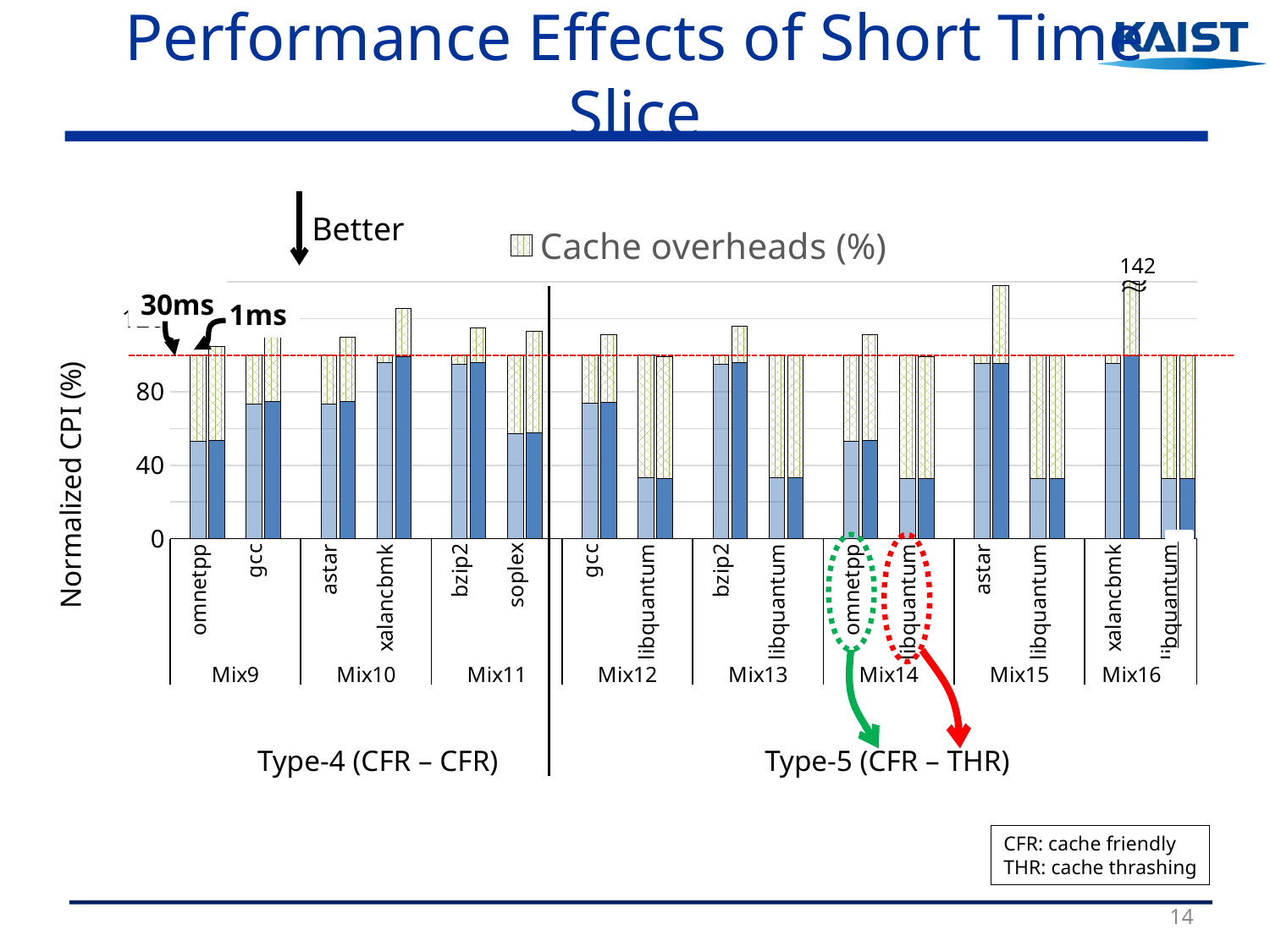
Is the solid (non-hatched) portion of the bars for omnetpp in Mix9 greater or less than 80? less In Mix9, which benchmark has the larger solid (non-hatched) bar portion, omnetpp or gcc? gcc What kind of chart is shown on the slide? bar chart In Mix16, which benchmark has the taller total bar, xalancbmk or libquantum? xalancbmk How many benchmark categories are shown in the Mix10 group? 2 How many Mix groups are shown along the x-axis? 8 Is the total height of the bars for libquantum in Mix12 greater or less than 80? greater What entry does the chart legend list? Cache overheads (%) Is the solid (non-hatched) portion of the bars for libquantum in Mix12 greater or less than 40? less What value is printed above the tallest bar in the chart? 142 What is the label of the y-axis? Normalized CPI (%) Which benchmark has the tallest bar in the chart? xalancbmk (Mix16)